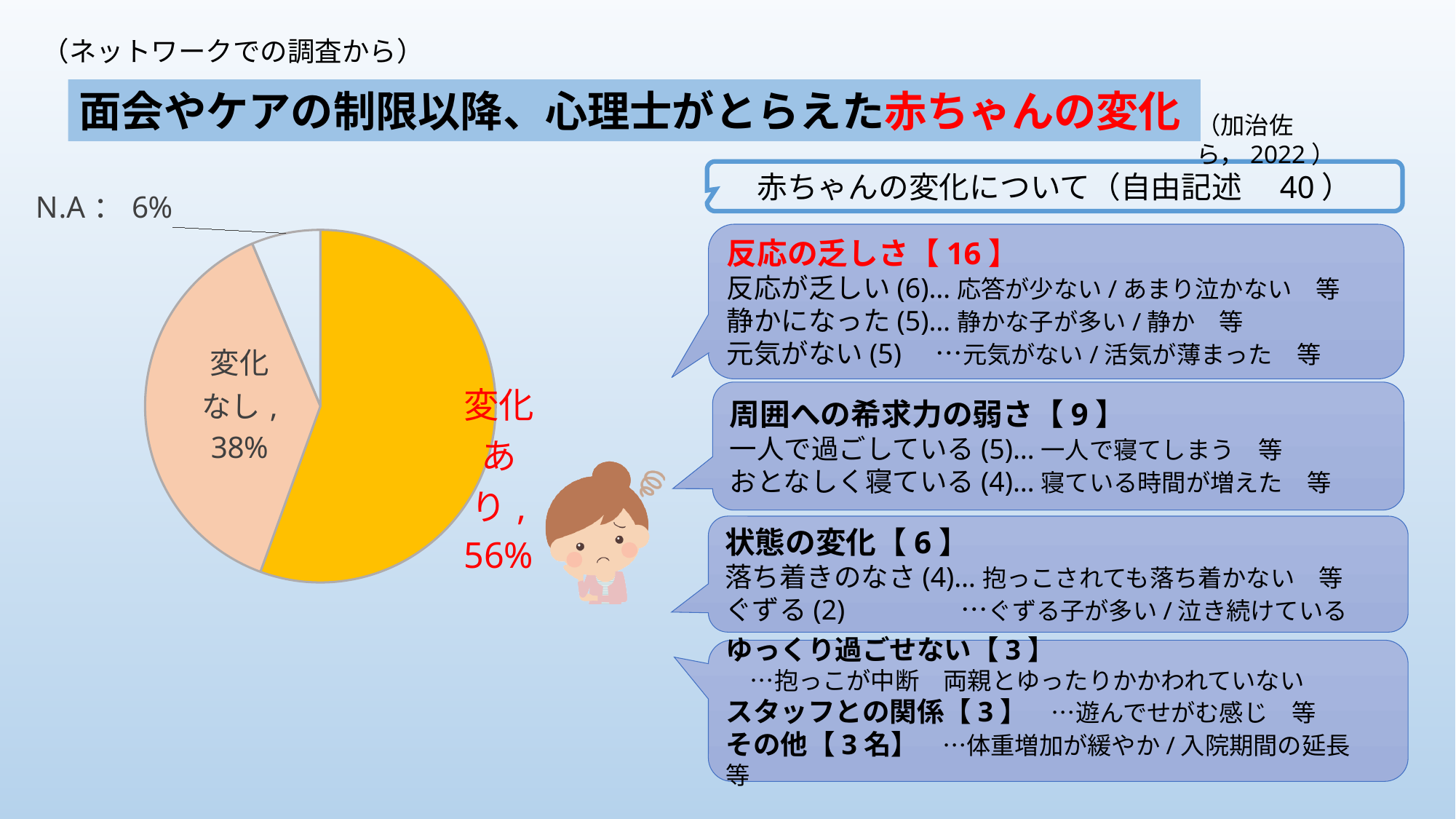
What share of the pie chart is labelled 変化なし? 38% What is the difference in percentage points between the 変化あり slice and the 変化なし slice? 18 What colour is the 変化あり slice of the pie chart? orange/yellow Which slice of the pie chart is the largest? 変化あり Which is larger in the pie chart, 変化なし or N.A? 変化なし What share of the pie chart is labelled 変化あり? 56% Which slice of the pie chart is the smallest? N.A What is the combined share of the 変化あり and 変化なし slices? 94% What kind of chart is shown on the left of the slide? pie chart What share of the pie chart is labelled N.A? 6% Is the share of the 変化あり slice greater or less than 50%? greater How many slices does the pie chart have? 3